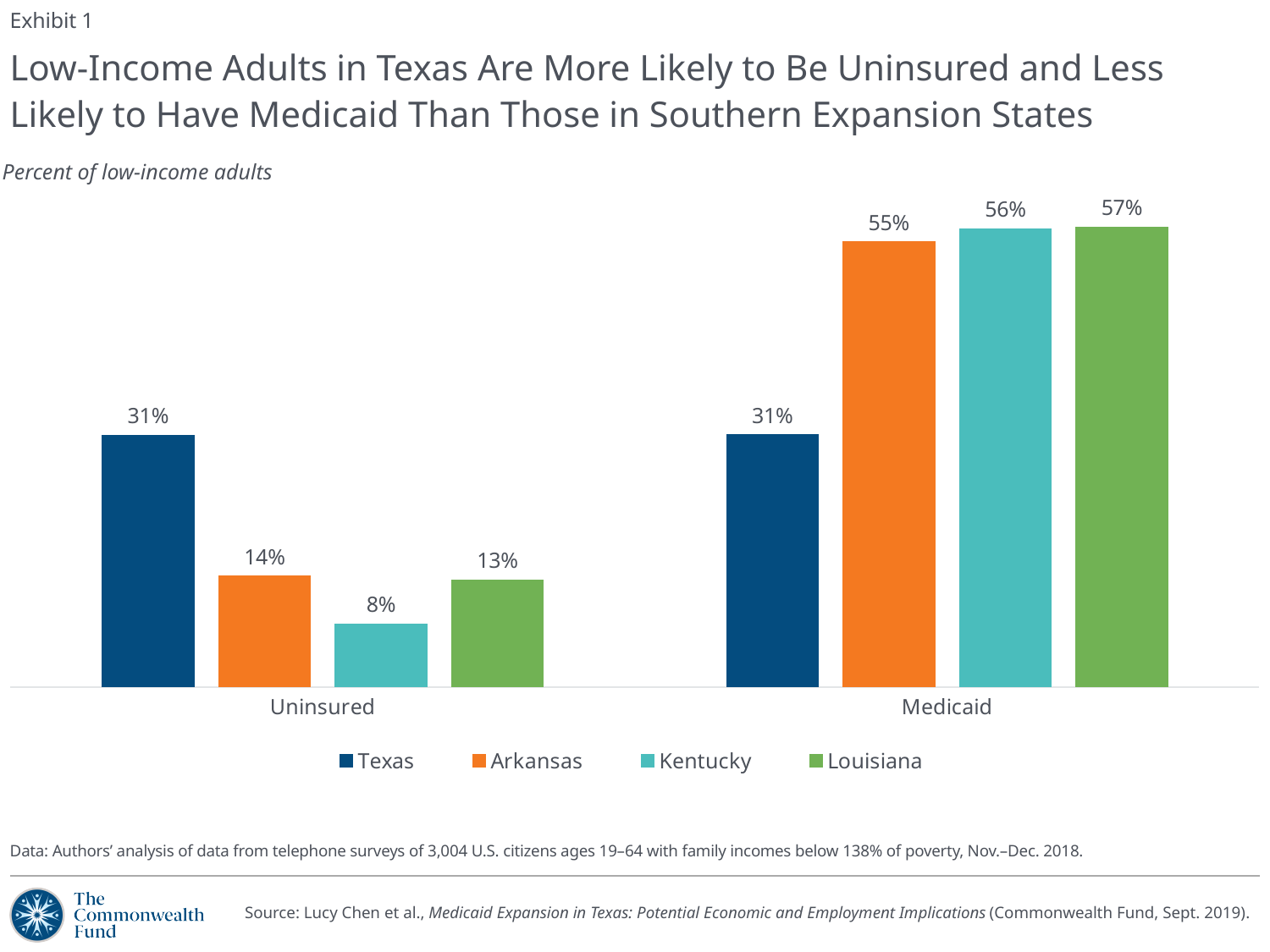
How many categories are shown on the x axis? 2 How many series does the legend list? 4 What percentage of low-income adults in Kentucky have Medicaid? 56% Which state has the lowest uninsured rate among low-income adults? Kentucky What percentage of low-income adults in Texas are uninsured? 31% What type of chart is shown on the slide? Bar chart Which state has the highest uninsured rate among low-income adults? Texas Is the uninsured rate higher in Arkansas or in Louisiana? Arkansas What is the difference between the uninsured rates for Arkansas and Kentucky? 6 percentage points What is the difference between the Medicaid rates for Louisiana and Texas? 26 percentage points What is the value for Louisiana in the Uninsured category? 13% Which state has the lowest Medicaid coverage rate among low-income adults? Texas